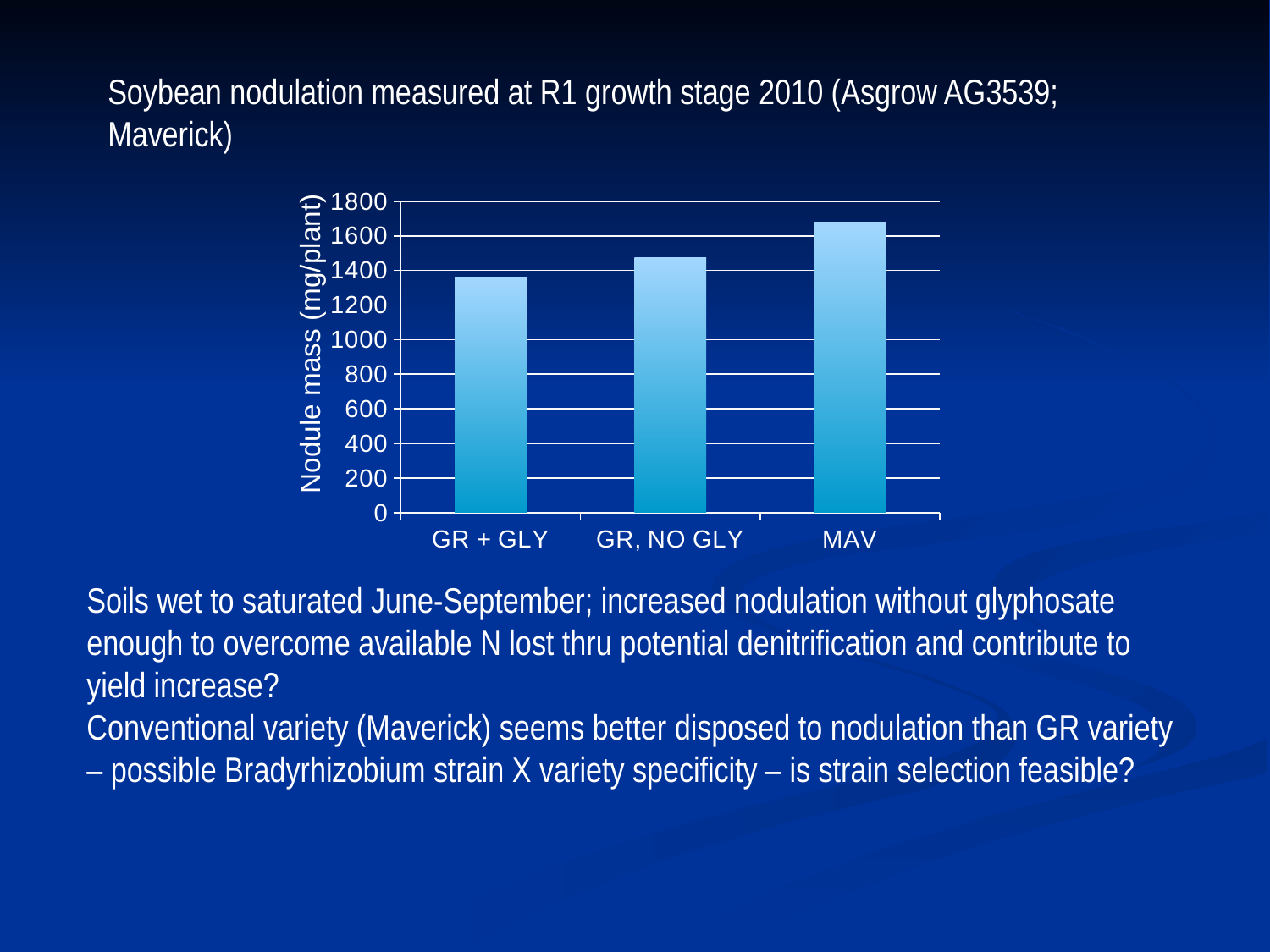
How many categories are plotted on the x axis of the chart? 3 What is the label of the vertical axis of the chart? Nodule mass (mg/plant) What kind of chart is shown on the slide? bar chart Which has a larger nodule mass, MAV or GR, NO GLY? MAV Is the value for MAV greater or less than 1600? greater Is the value for GR, NO GLY greater or less than 1400? greater Do the bar values rise or fall from left to right across the x axis? rise Is the value for GR, NO GLY greater or less than 1600? less Which category has the highest nodule mass? MAV Which has a larger nodule mass, GR + GLY or GR, NO GLY? GR, NO GLY Which category has the lowest nodule mass? GR + GLY